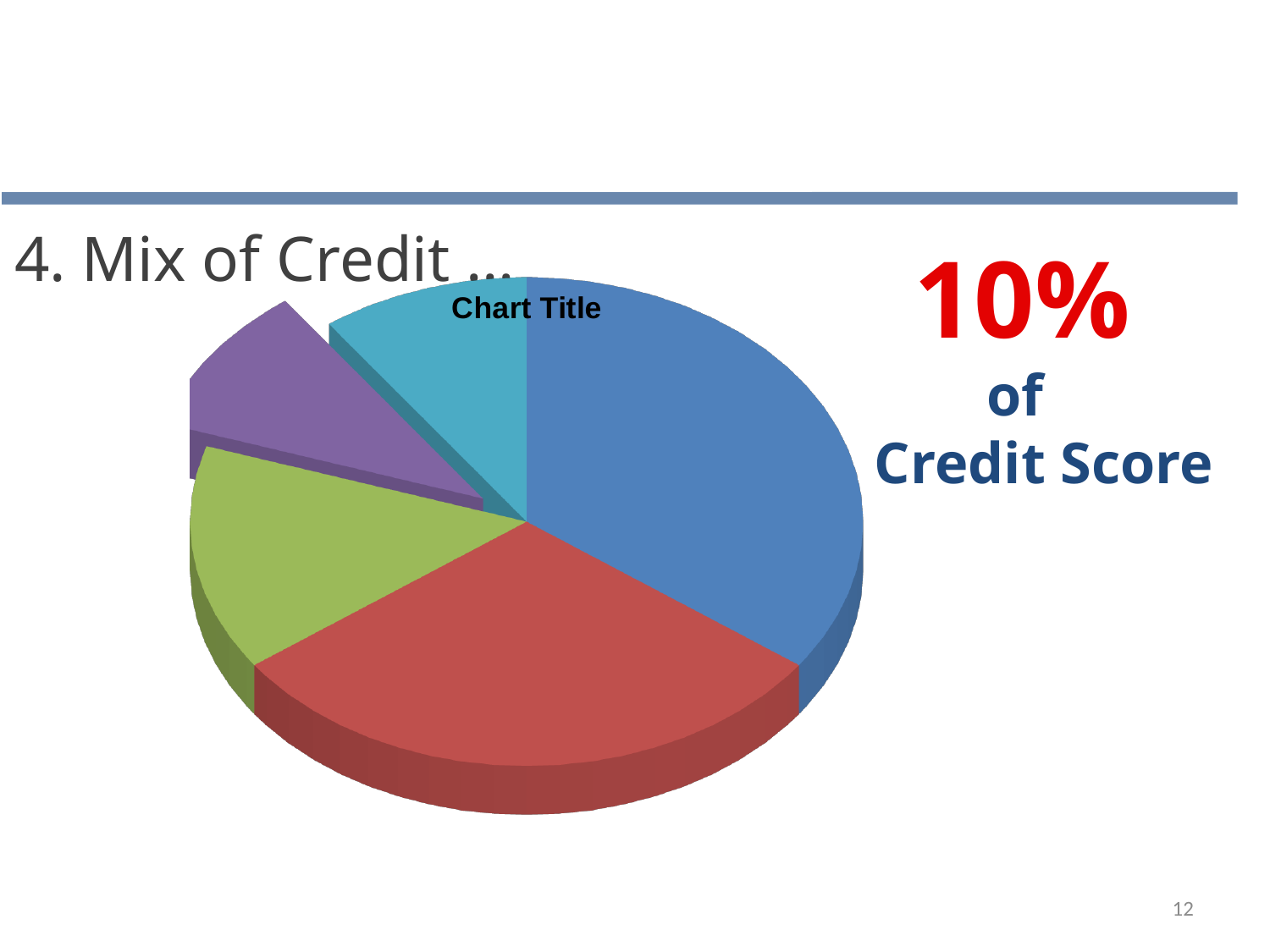
Which slice is larger, the red slice or the cyan slice? red Which colour slice is pulled out (exploded) from the pie chart? purple Which colour slice is the largest in the pie chart? blue What is the title shown on the chart? Chart Title Which slice is larger, the blue slice or the green slice? blue Which slice is larger, the red slice or the purple slice? red How many slices does the pie chart have? 5 What kind of chart is shown on the slide? pie chart